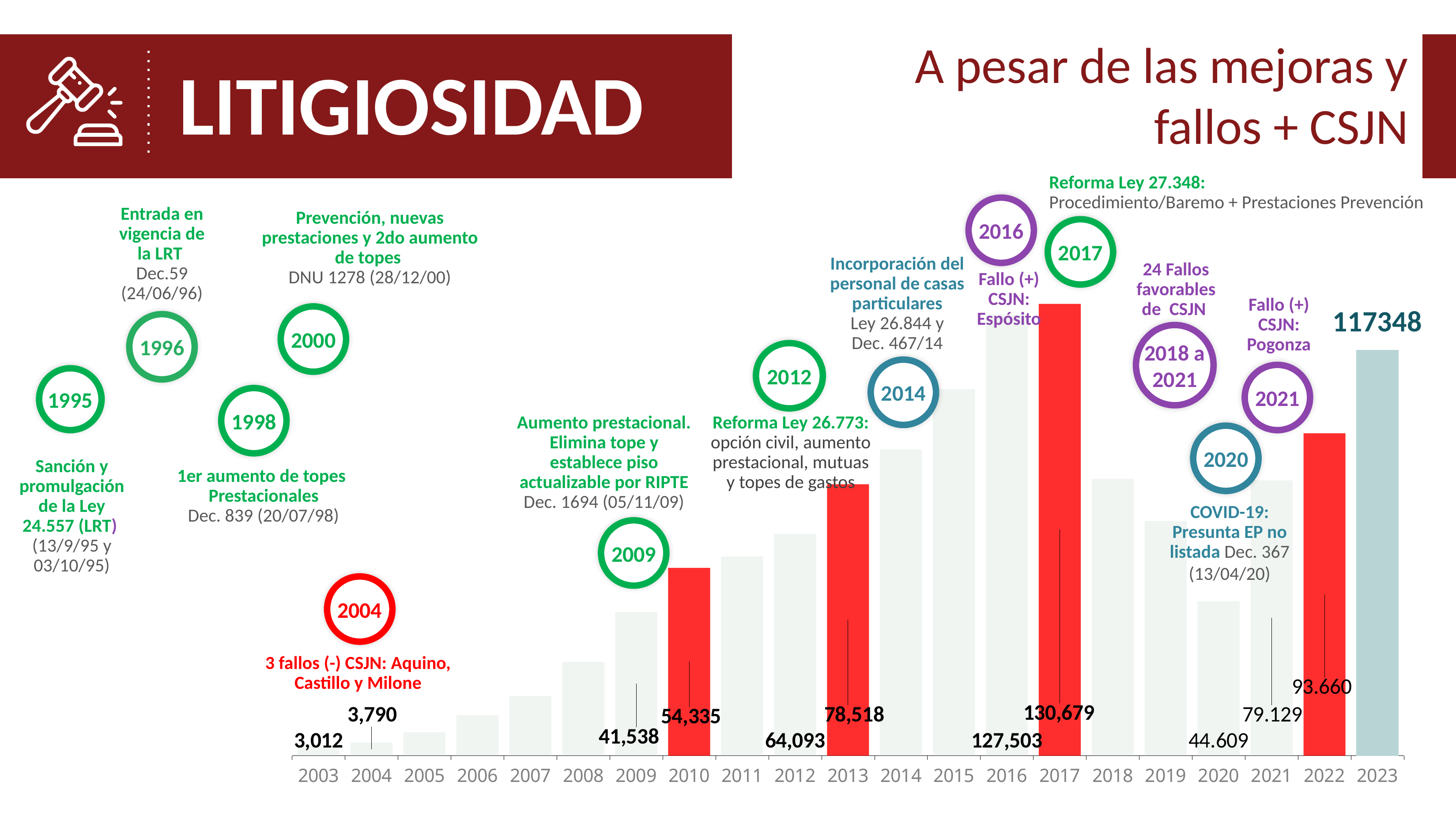
What is the value shown for 2020? 44.609 Which year has the lowest bar? 2003 What is the difference between the values for 2022 and 2021? 14.531 What type of chart is shown on the slide? bar chart What is the difference between the values for 2017 and 2016? 3,176 How many years are shown on the x axis? 21 Do the values rise or fall from 2003 to 2017? rise Which year has the highest bar? 2017 What is the value shown for 2023? 117348 Which is larger, the value for 2010 or the value for 2009? 2010 What is the value shown for 2017? 130,679 What is the value shown for 2003? 3,012